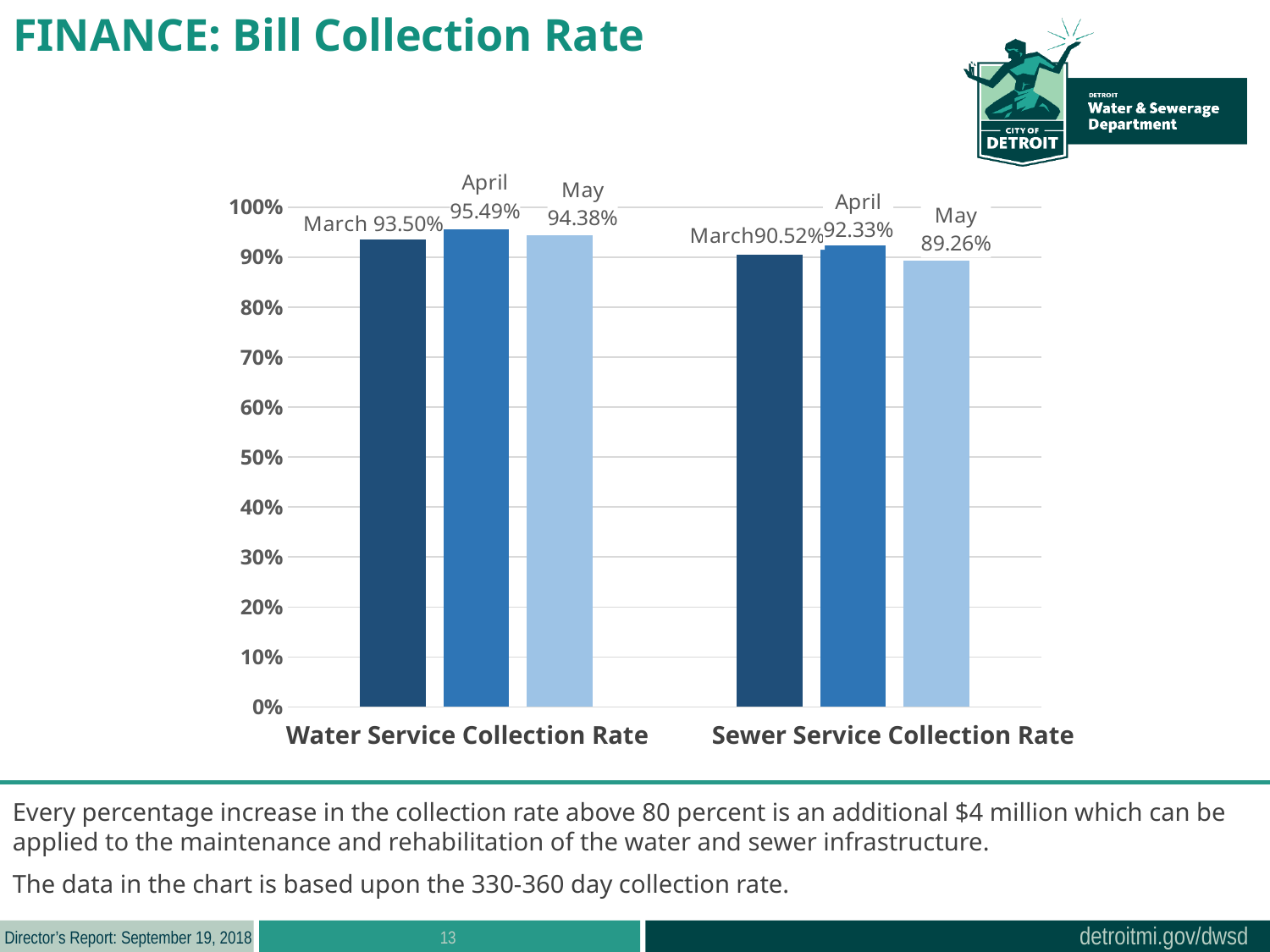
How many categories are shown on the x axis? 2 What is the March value for Water Service Collection Rate? 93.50% Which month has the highest Water Service Collection Rate? April What is the April value for Sewer Service Collection Rate? 92.33% What kind of chart is shown on the slide? bar chart What is the title of the slide containing the chart? FINANCE: Bill Collection Rate Is the May Sewer Service Collection Rate greater or less than 90%? less Which is larger, the May Water Service Collection Rate or the May Sewer Service Collection Rate? May Water Service Collection Rate Which month has the lowest Sewer Service Collection Rate? May What is the May value for Sewer Service Collection Rate? 89.26% What is the difference between the April and March Water Service Collection Rates? 1.99% What is the difference between the April and May Sewer Service Collection Rates? 3.07%